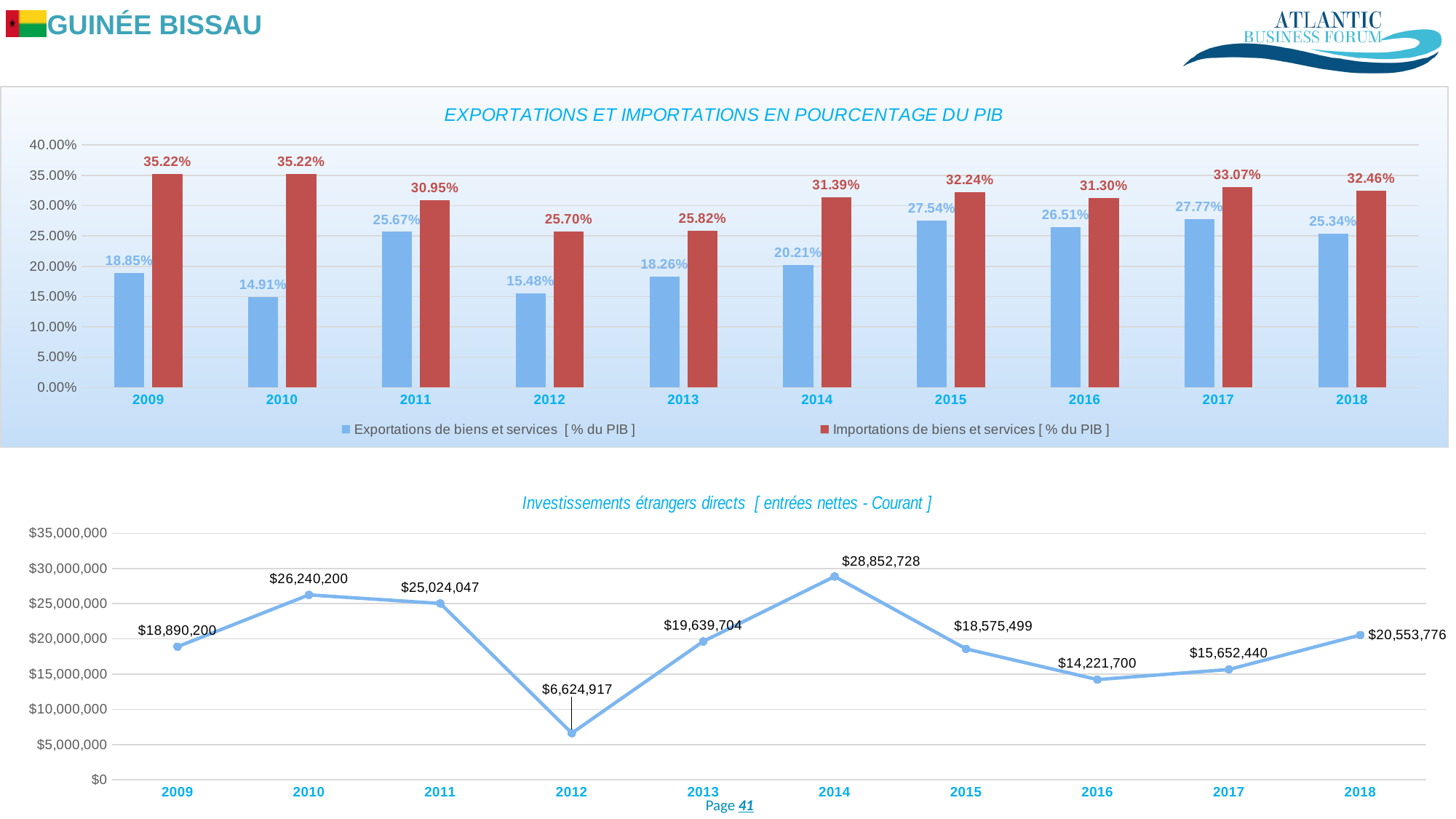
In the chart 'EXPORTATIONS ET IMPORTATIONS EN POURCENTAGE DU PIB', which year has the lowest value for Exportations de biens et services? 2010 In the chart 'EXPORTATIONS ET IMPORTATIONS EN POURCENTAGE DU PIB', what is the value of Exportations de biens et services for 2011? 25.67% In the chart 'Investissements étrangers directs', what is the value for 2014? $28,852,728 In the chart 'EXPORTATIONS ET IMPORTATIONS EN POURCENTAGE DU PIB', which year has the highest value for Exportations de biens et services? 2017 In the chart 'EXPORTATIONS ET IMPORTATIONS EN POURCENTAGE DU PIB', what is the difference between Importations and Exportations in 2009? 16.37% How many series does the legend of the chart 'EXPORTATIONS ET IMPORTATIONS EN POURCENTAGE DU PIB' list? 2 In the chart 'Investissements étrangers directs', which year has the lowest value? 2012 In the chart 'Investissements étrangers directs', what is the difference between the 2010 and 2009 values? $7,350,000 In the chart 'Investissements étrangers directs', which is larger, the value for 2015 or the value for 2016? 2015 In the chart 'EXPORTATIONS ET IMPORTATIONS EN POURCENTAGE DU PIB', what is the value of Importations de biens et services for 2017? 33.07% What kind of chart is 'EXPORTATIONS ET IMPORTATIONS EN POURCENTAGE DU PIB'? Bar chart What kind of chart is 'Investissements étrangers directs'? Line chart